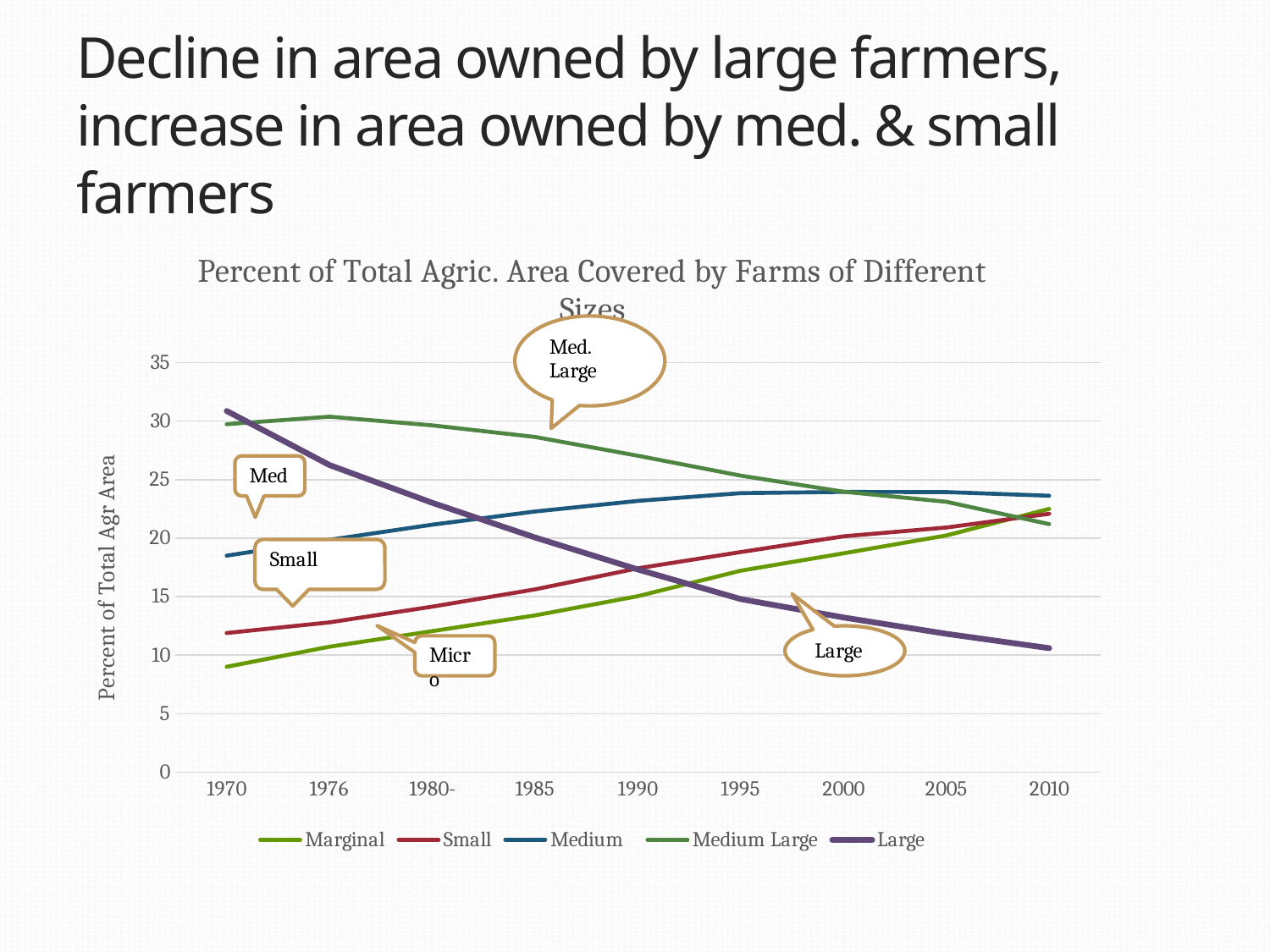
Does the Large series rise or fall from 1970 to 2010? fall Which series has the lowest value in 1970? Marginal Which series has the lowest value in 2010? Large How many year points are shown along the x axis? 9 In 1990, which is larger: Medium or Small? Medium What kind of chart is shown on the slide? line chart Does the Marginal series rise or fall from 1970 to 2010? rise How many series does the legend list? 5 What is the label on the y axis? Percent of Total Agr Area Is the value for Large in 2010 greater or less than 15? less Is the value for Medium Large in 1985 greater or less than 25? greater